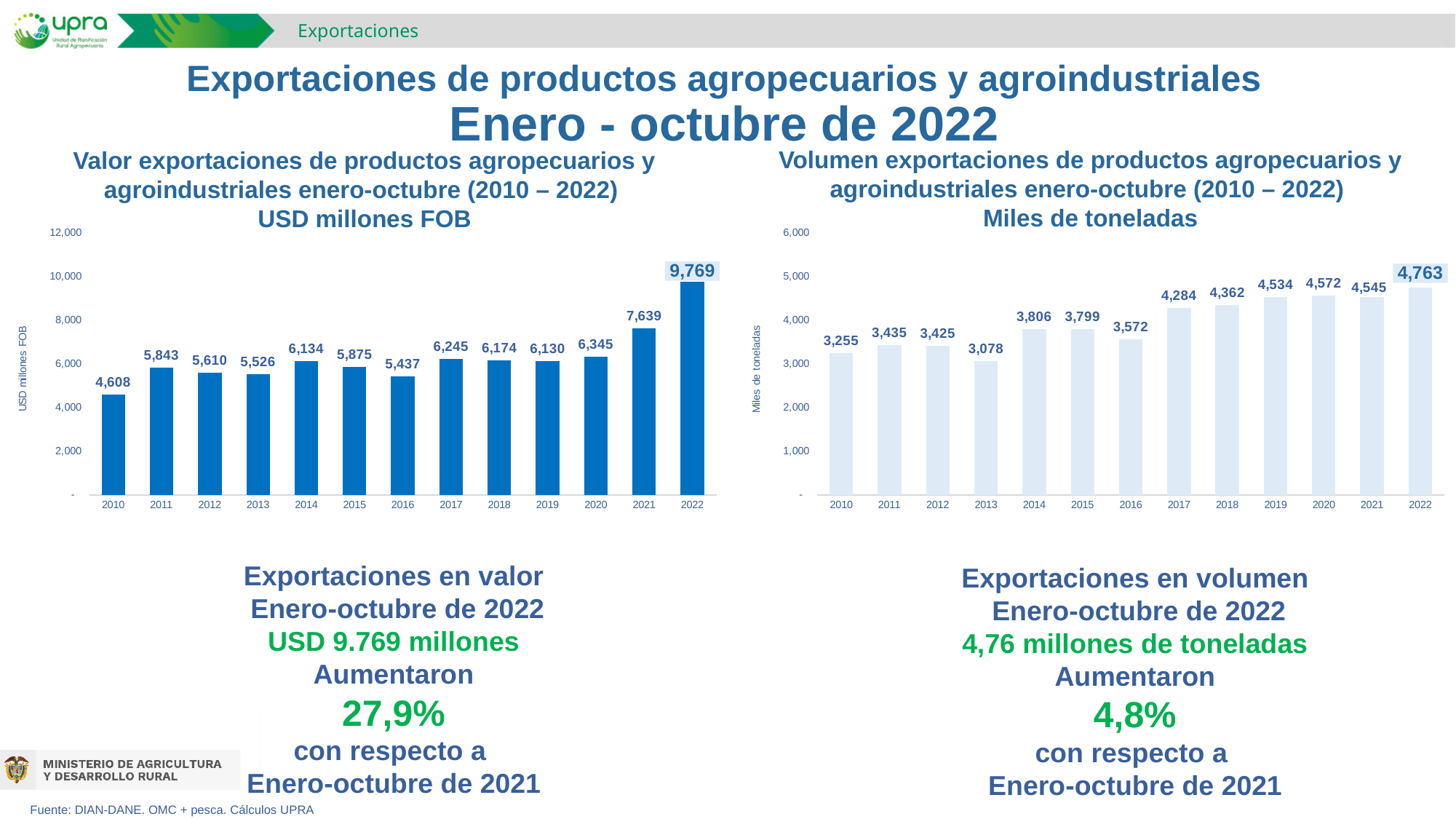
In the left chart (Valor exportaciones, USD millones FOB), which year has the lowest value? 2010 In the left chart (Valor exportaciones, USD millones FOB), what is the value for 2022? 9,769 In the left chart (Valor exportaciones, USD millones FOB), what is the difference between the 2022 and 2021 values? 2,130 What is the y-axis label of the left chart (Valor exportaciones)? USD millones FOB In the left chart (Valor exportaciones, USD millones FOB), is the value for 2021 greater or less than 8,000? less In the right chart (Volumen exportaciones, Miles de toneladas), which year has the highest value? 2022 In the right chart (Volumen exportaciones, Miles de toneladas), which is larger, the value for 2014 or the value for 2016? 2014 In the right chart (Volumen exportaciones, Miles de toneladas), what is the difference between the 2022 and 2021 values? 218 In the left chart (Valor exportaciones, USD millones FOB), what is the value for 2016? 5,437 In the left chart (Valor exportaciones, USD millones FOB), how many years are plotted? 13 In the right chart (Volumen exportaciones, Miles de toneladas), what is the value for 2013? 3,078 What kind of chart is the right chart (Volumen exportaciones, Miles de toneladas)? bar chart